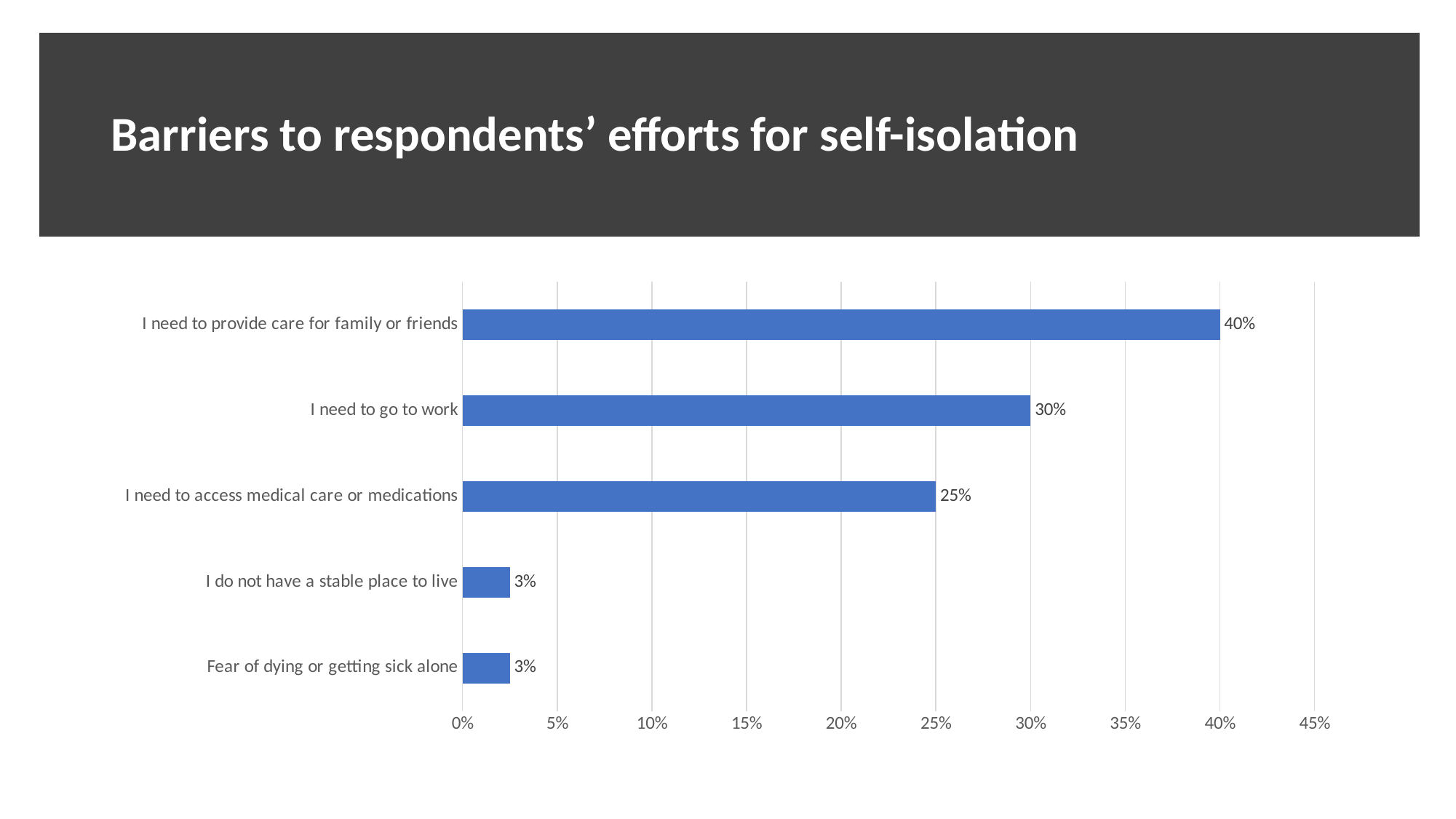
Which barrier has the highest value? I need to provide care for family or friends What is the value for "I need to go to work"? 30% What is the difference between "I need to provide care for family or friends" and "I need to go to work"? 10% What percentage of respondents said "I need to provide care for family or friends"? 40% What is the title of the slide? Barriers to respondents' efforts for self-isolation Which is larger: "I need to access medical care or medications" or "I do not have a stable place to live"? I need to access medical care or medications What is the value for "Fear of dying or getting sick alone"? 3% What kind of chart is shown on the slide? Bar chart Is the value for "I need to go to work" greater or less than 20%? greater How many barriers are shown in the chart? 5 What is the difference between "I need to go to work" and "I need to access medical care or medications"? 5% What is the value for "I need to access medical care or medications"? 25%